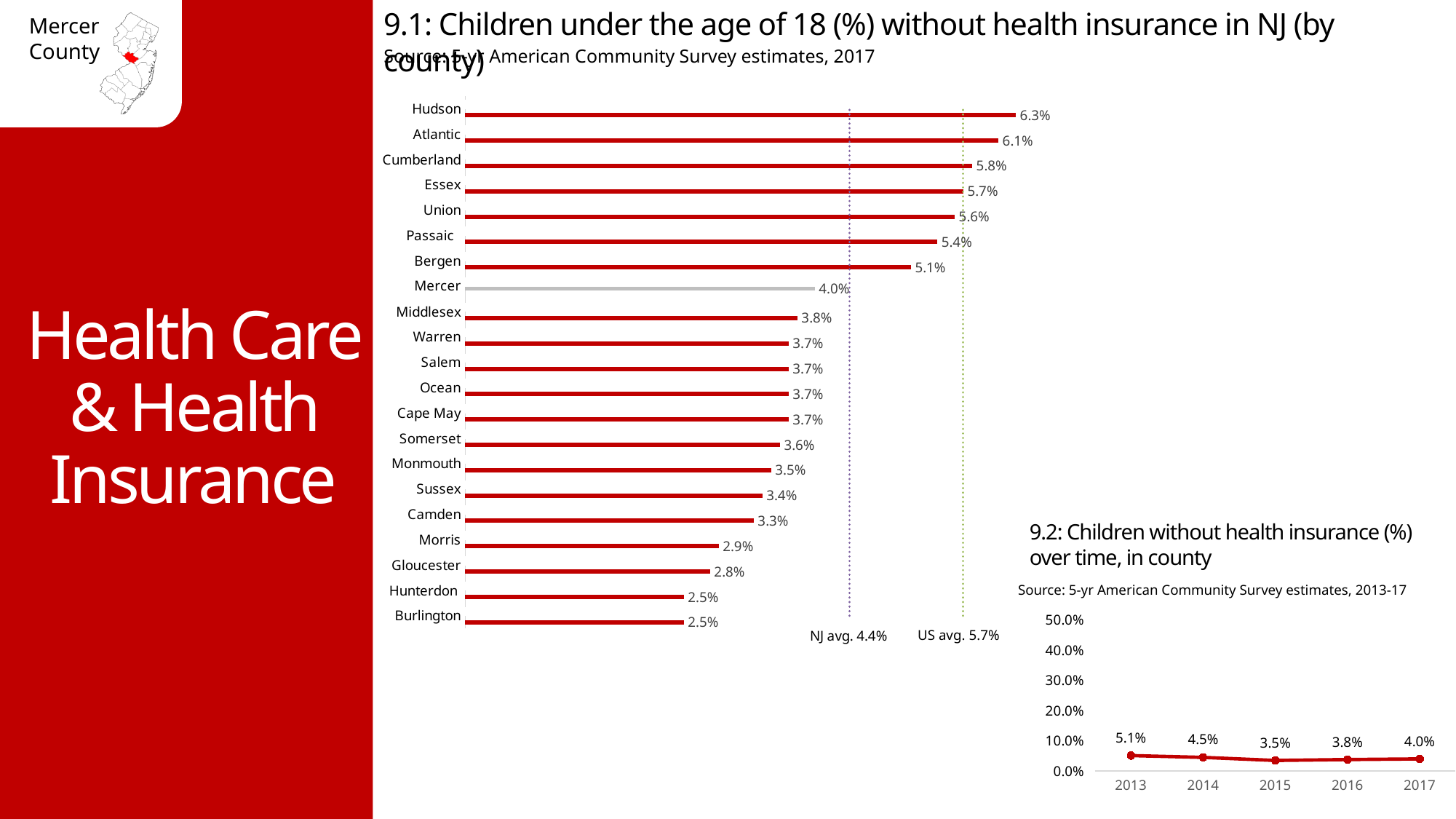
In chart 9.2 (children without health insurance over time), what is the value for 2015? 3.5% In chart 9.1, how many counties are plotted? 21 What type of chart is chart 9.1? Bar chart What type of chart is chart 9.2? Line chart In chart 9.1, what is the value for Passaic? 5.4% In chart 9.1, what NJ average is marked by the dotted reference line? 4.4% In chart 9.1, which county has the highest percentage of children without health insurance? Hudson In chart 9.1, what is the difference between Hudson and Burlington? 3.8% In chart 9.1, which is larger, the value for Bergen or the value for Middlesex? Bergen In chart 9.1 (children under 18 without health insurance by county), what is the value for Mercer? 4.0% In chart 9.2, what is the difference between the 2013 and 2017 values? 1.1% In chart 9.2, which year has the highest value? 2013